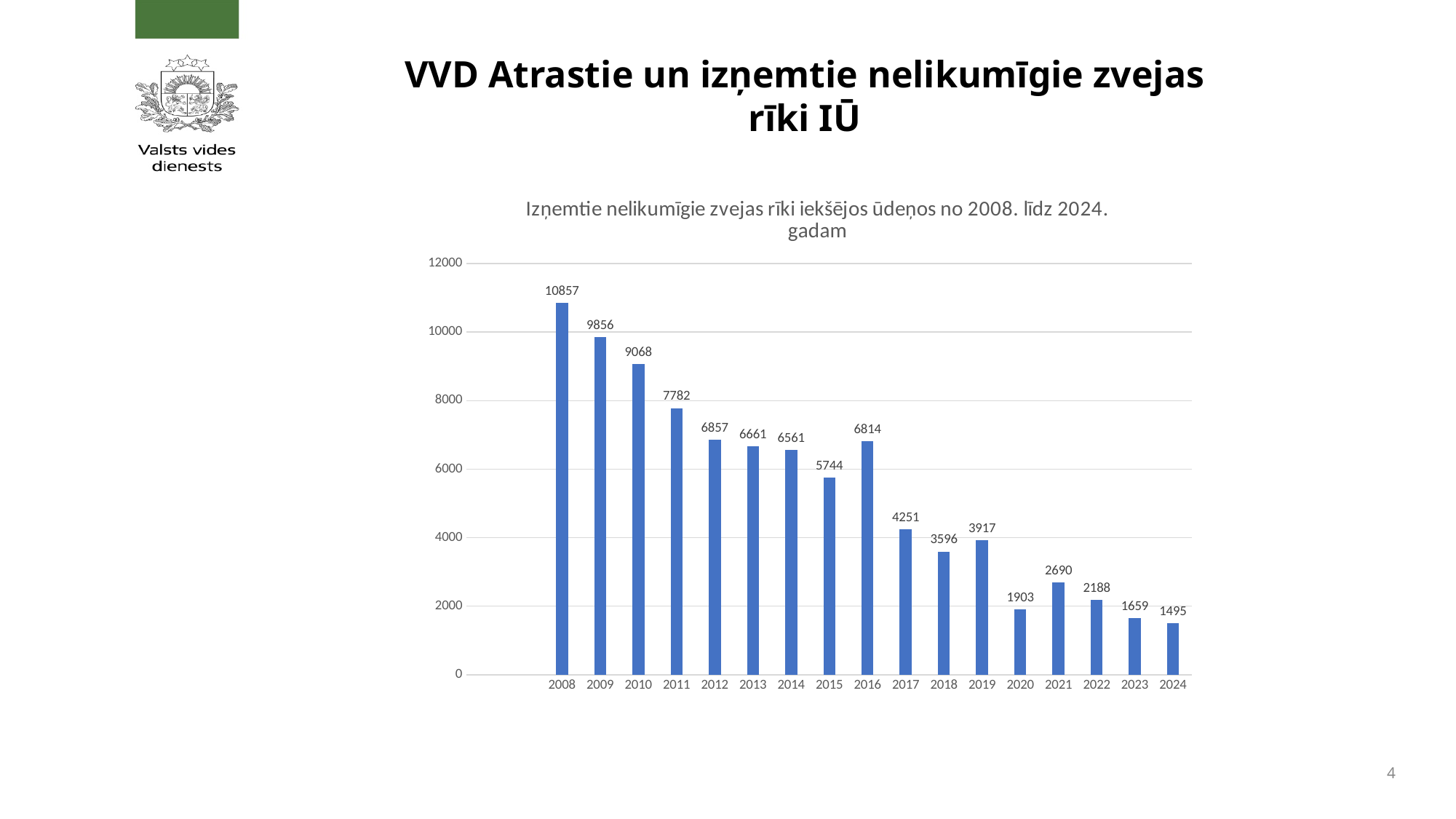
What is the difference between the values for 2008 and 2009? 1001 What is the difference between the values for 2020 and 2021? 787 What is the value for 2024? 1495 What kind of chart is shown on the slide? bar chart What is the value for 2016? 6814 How many years are shown on the x axis? 17 Do the values generally rise or fall from 2008 to 2024? fall Which year has the highest value? 2008 Which is larger, the value for 2012 or the value for 2016? 2012 Is the value for 2011 greater or less than 8000? less What is the value for 2008? 10857 Which year has the lowest value? 2024